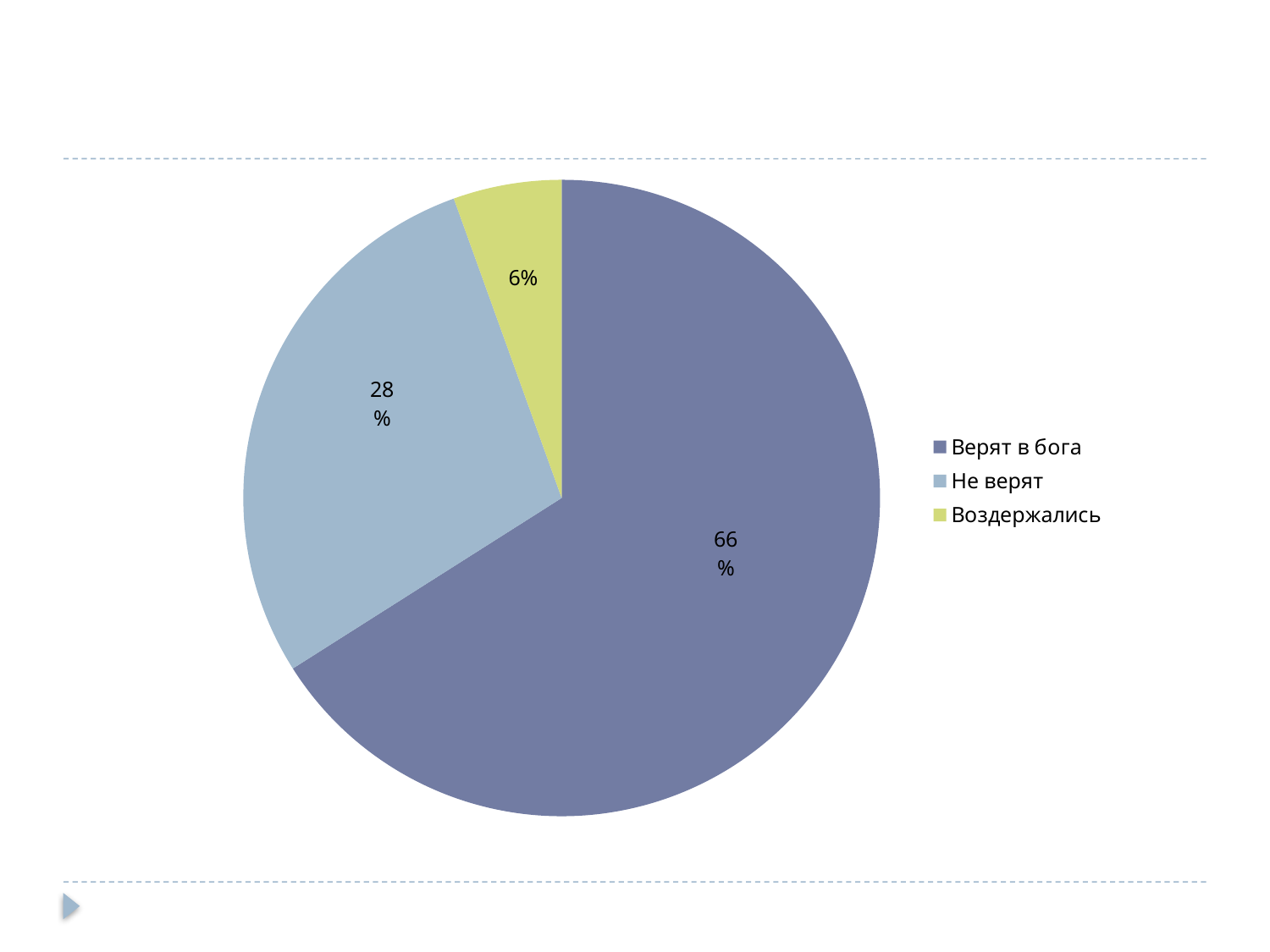
What share of the pie does "Не верят" take? 28% What is the difference in percentage points between "Не верят" and "Воздержались"? 22 What share of the pie does "Воздержались" take? 6% How many entries does the legend list? 3 Which category has the largest slice of the pie? Верят в бога Which is larger, the slice for "Не верят" or the slice for "Воздержались"? Не верят What colour is the slice for "Воздержались"? yellow-green What kind of chart is shown on the slide? pie chart What is the difference in percentage points between "Верят в бога" and "Не верят"? 38 How many slices does the pie chart have? 3 What share of the pie does "Верят в бога" take? 66% Which category has the smallest slice of the pie? Воздержались